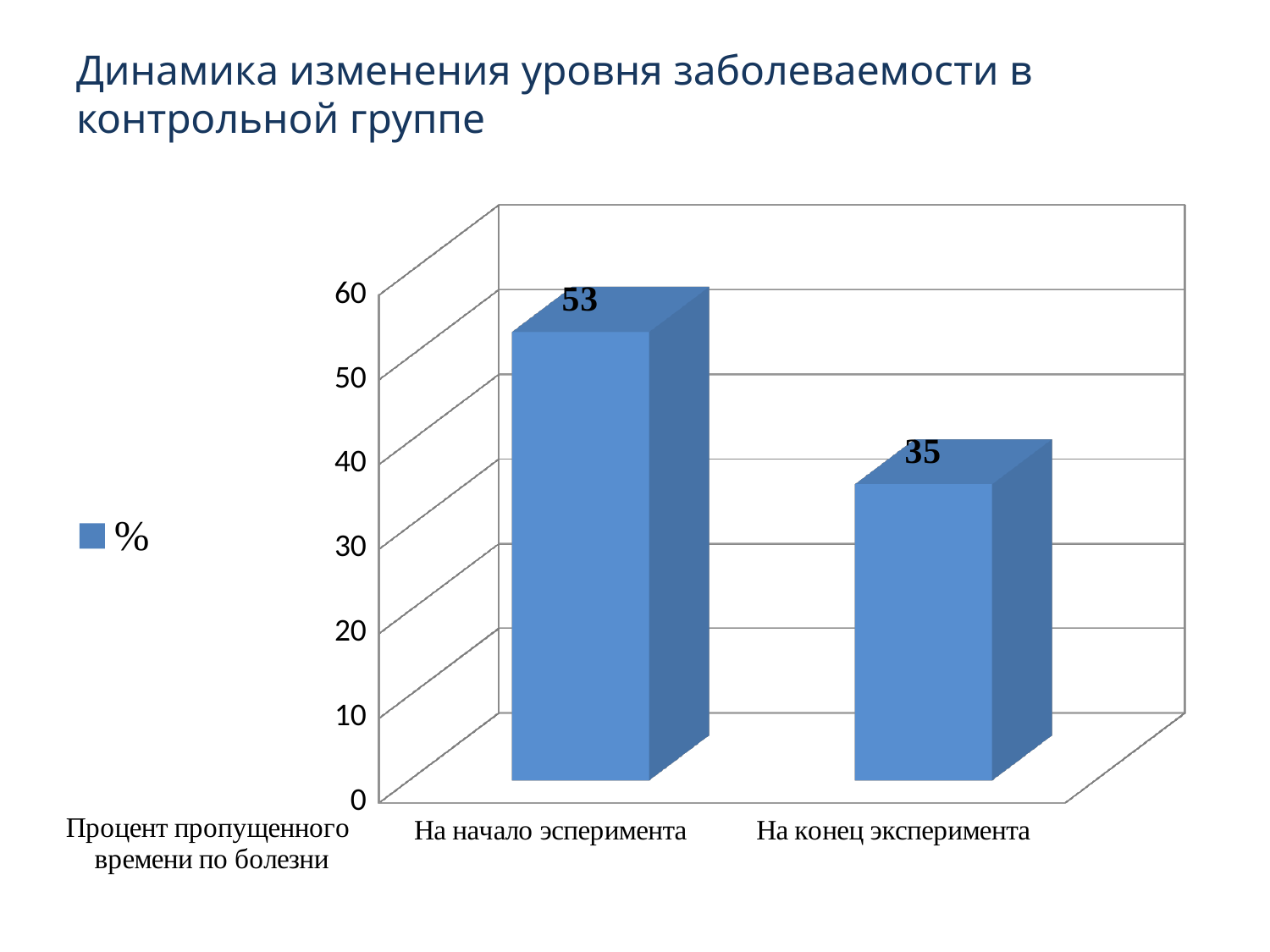
What is the difference between the values for "На начало эсперимента" and "На конец эксперимента"? 18 Is the value for "На конец эксперимента" greater or less than 40? less What is the value for "На конец эксперимента"? 35 What kind of chart is shown on the slide? Bar chart Which category has the highest value? На начало эсперимента Do the values rise or fall from the start to the end of the experiment? Fall How many categories are shown on the chart? 2 Is the value for "На начало эсперимента" greater or less than 50? greater What is the value for "На начало эсперимента"? 53 How many series does the legend list? 1 Which is larger: the value for "На начало эсперимента" or for "На конец эксперимента"? На начало эсперимента Which category has the lowest value? На конец эксперимента